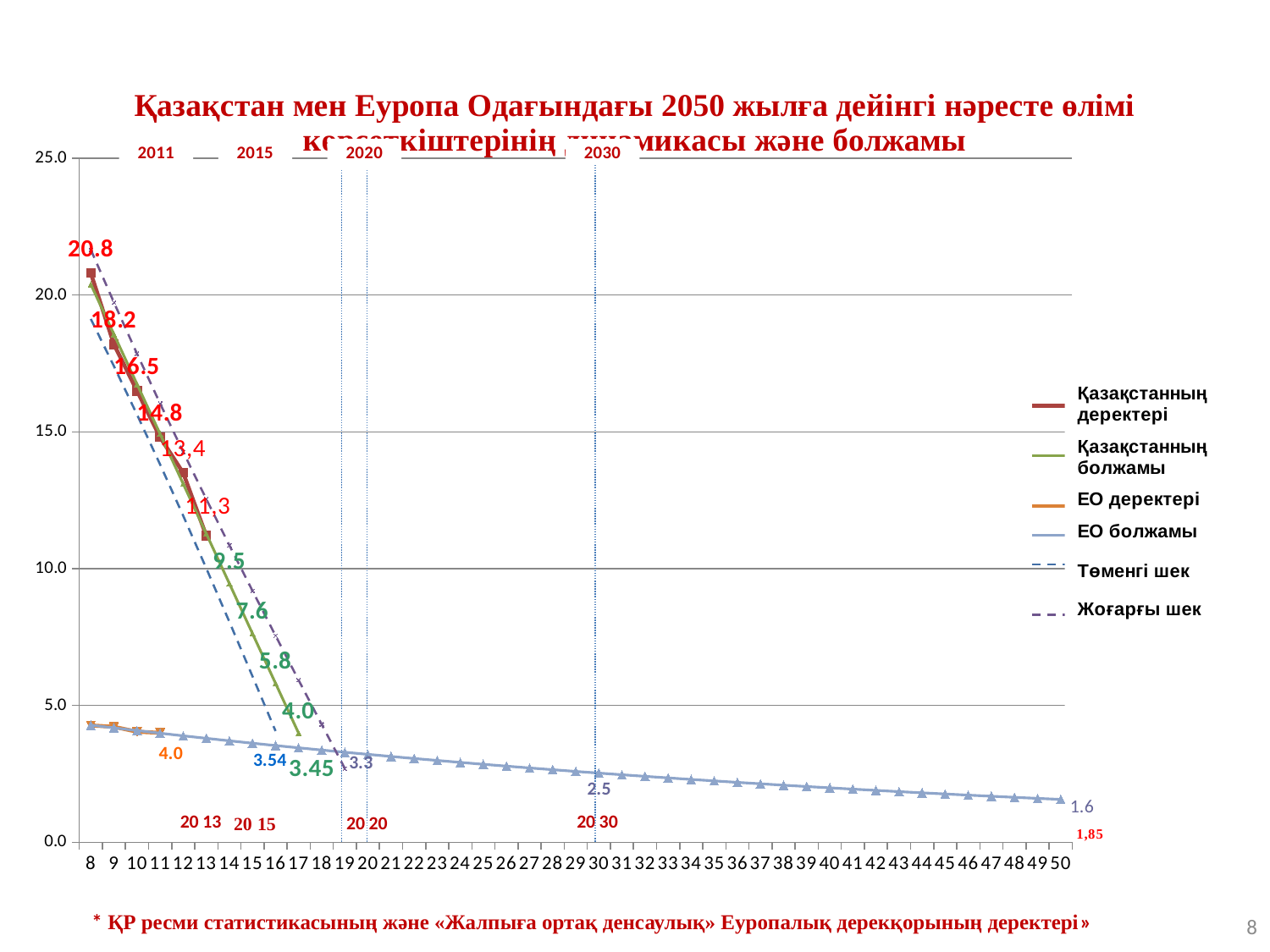
What is the first (highest) labelled value of the Қазақстанның деректері series? 20.8 Is the value of the ЕО болжамы series at x = 40 greater or less than 5.0? less Which legend entry corresponds to the purple dashed line? Жоғарғы шек What is the difference between the first two labelled values of the Қазақстанның деректері series (20.8 and 18.2)? 2.6 Do the values of the Қазақстанның деректері series rise or fall along the x axis? fall What is the last labelled value of the ЕО болжамы series at the right end of the chart (x = 50)? 1.6 How many series does the legend list? 6 What is the labelled value of the ЕО болжамы series at the 2020 marker? 3.3 What is the labelled value of the ЕО болжамы series at the 2030 marker? 2.5 What type of chart is shown on the slide? line chart What is the last labelled value of the Қазақстанның болжамы series? 3.45 Which is larger: the last Қазақстанның деректері value (11.3) or the ЕО деректері value labelled 4.0? Қазақстанның деректері (11.3)